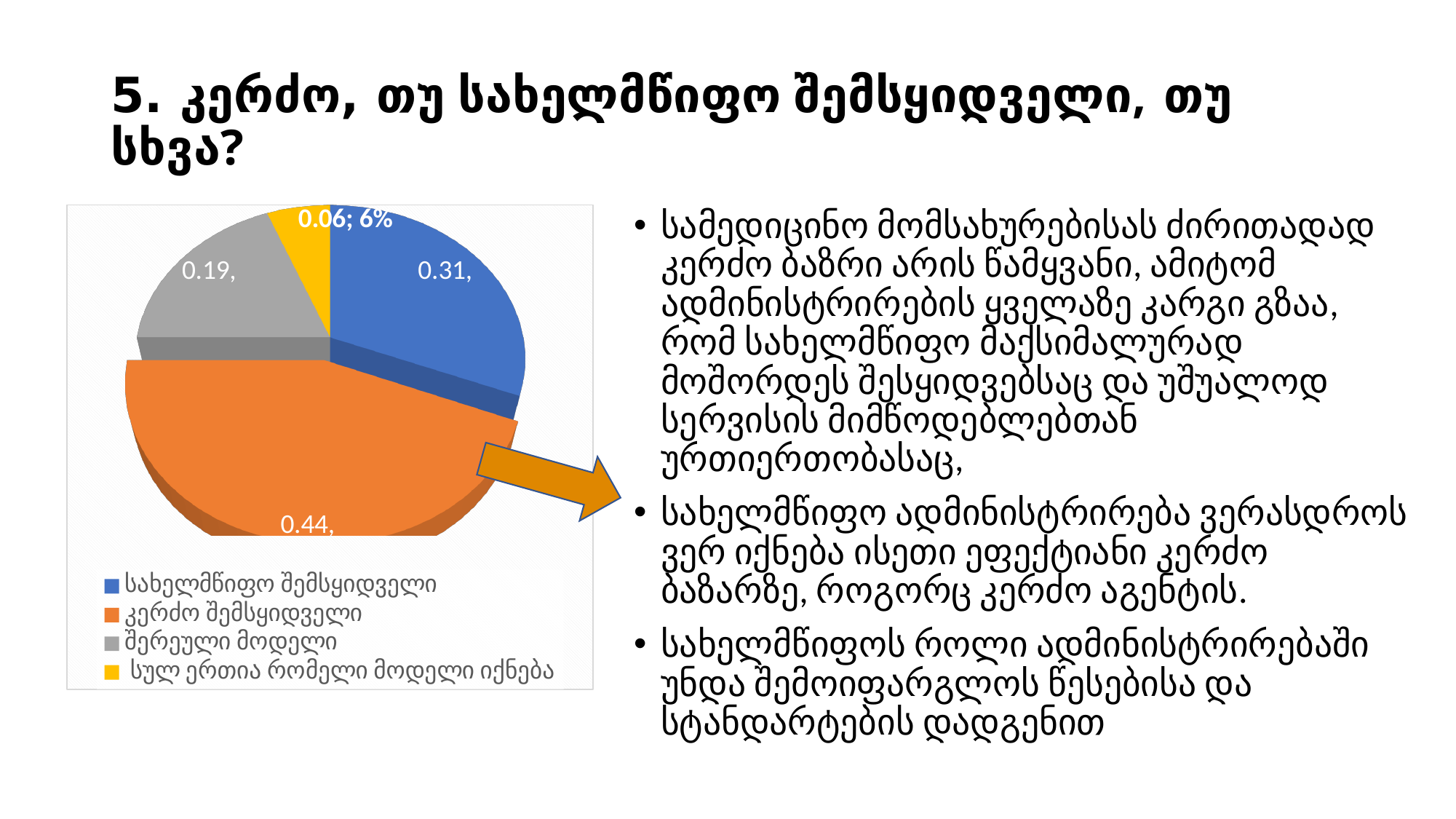
Which slice of the pie chart is the largest? კერძო შემსყიდველი What value is shown for the slice labelled სახელმწიფო შემსყიდველი? 0.31 Which is larger, the slice for სახელმწიფო შემსყიდველი or the slice for შერეული მოდელი? სახელმწიფო შემსყიდველი Which slice of the pie chart is the smallest? სულ ერთია რომელი მოდელი იქნება How many entries does the legend of the pie chart list? 4 How many slices does the pie chart have? 4 What is the difference between the values for კერძო შემსყიდველი and სახელმწიფო შემსყიდველი? 0.13 What value is shown for the slice labelled კერძო შემსყიდველი? 0.44 What colour is the slice for შერეული მოდელი? gray What kind of chart is shown on the slide? pie chart What value is shown for the slice labelled შერეული მოდელი? 0.19 What percentage is printed on the slice labelled სულ ერთია რომელი მოდელი იქნება? 6%